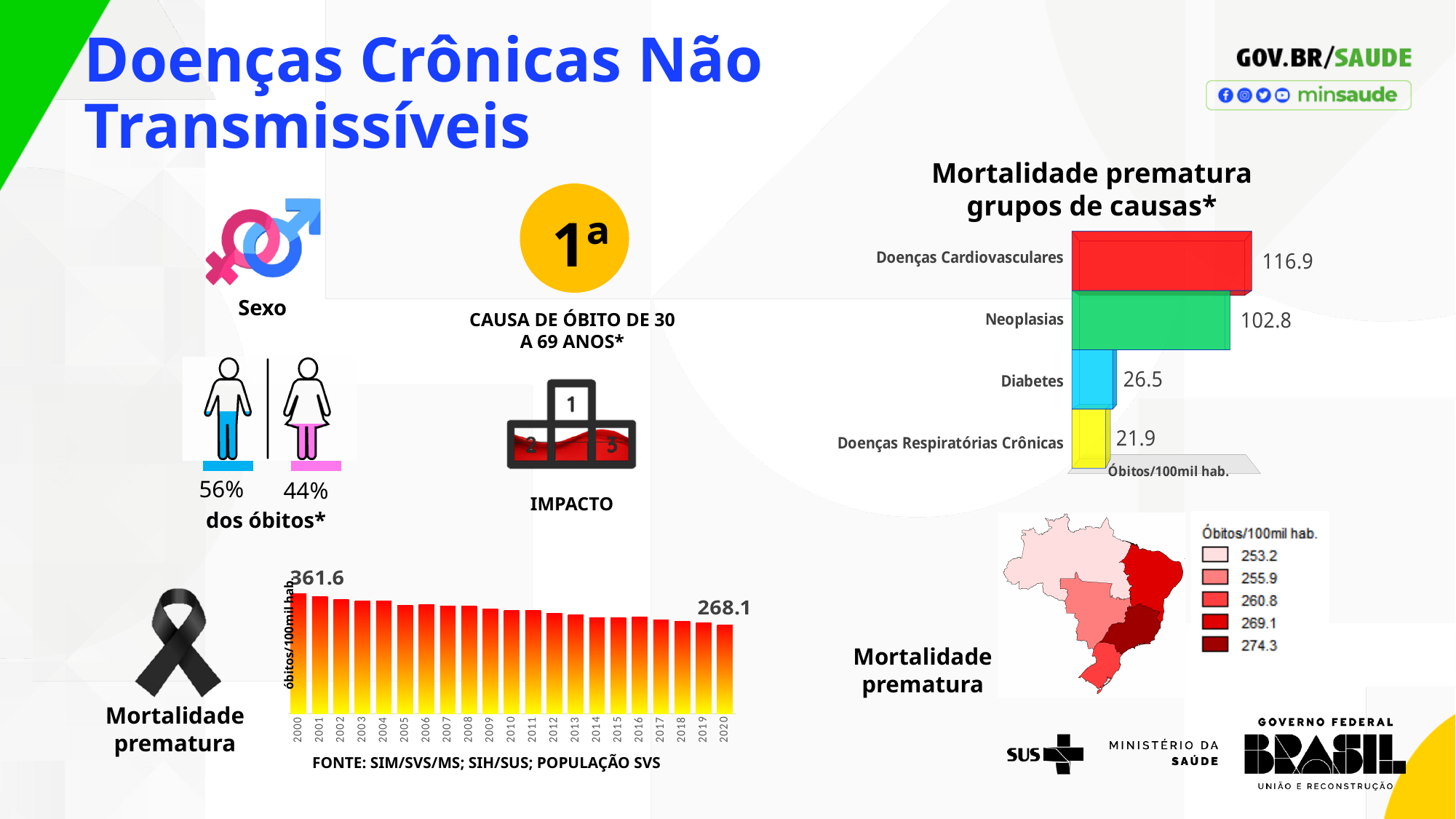
In the bottom-centre 'Mortalidade prematura' chart by year, what is the value for 2020? 268.1 In the 'Mortalidade prematura grupos de causas*' chart, what is the difference between Doenças Cardiovasculares and Neoplasias? 14.1 In the 'Mortalidade prematura grupos de causas*' chart, what is the value for Diabetes? 26.5 In the 'Mortalidade prematura grupos de causas*' chart, what is the value for Neoplasias? 102.8 In the bottom-centre 'Mortalidade prematura' chart by year, how many years are plotted? 21 What kind of chart is the 'Mortalidade prematura grupos de causas*' chart? Bar chart In the 'Mortalidade prematura grupos de causas*' chart, which cause group has the highest value? Doenças Cardiovasculares In the 'Mortalidade prematura grupos de causas*' chart, which cause group has the lowest value? Doenças Respiratórias Crônicas In the 'Mortalidade prematura grupos de causas*' chart, what is the value for Doenças Cardiovasculares? 116.9 In the 'Mortalidade prematura grupos de causas*' chart, how many cause groups are shown? 4 In the bottom-centre 'Mortalidade prematura' chart by year, do the values rise or fall from 2000 to 2020? Fall In the bottom-centre 'Mortalidade prematura' chart by year, what is the value for 2000? 361.6